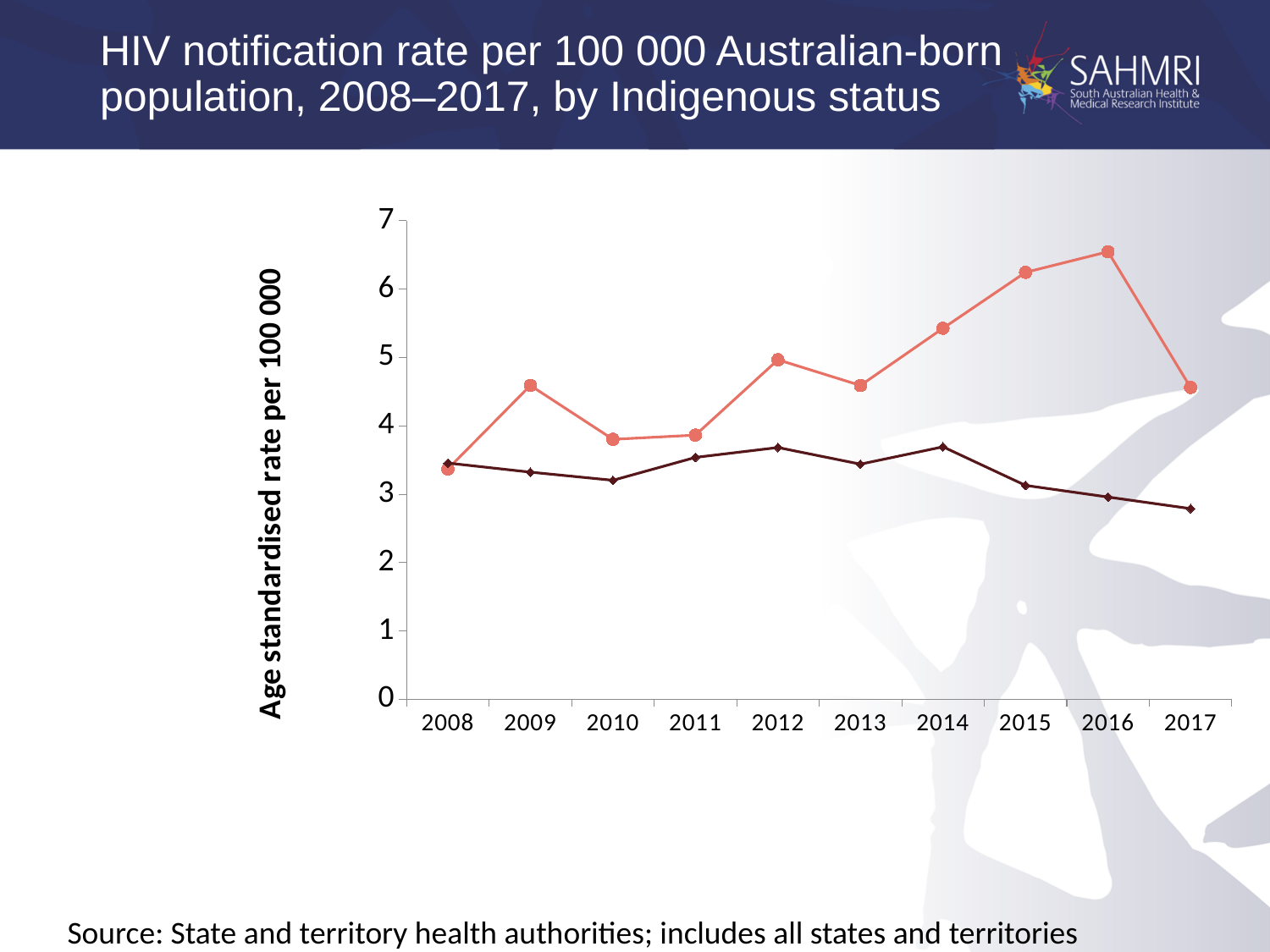
What is the first year shown on the x axis? 2008 Is the value of the orange line in 2014 greater or less than 5? greater Is the value of the orange line in 2016 greater or less than 6? greater What kind of chart is shown on the slide? line chart In which year does the orange line with circle markers reach its highest value? 2016 Is the value of the dark line in 2017 greater or less than 3? less Does the dark line rise or fall from 2014 to 2017? fall How many years are plotted along the x axis? 10 What is the label on the y axis? Age standardised rate per 100 000 In which year does the dark line with diamond markers reach its lowest value? 2017 In 2015, which line has the higher value, the orange line or the dark line? the orange line